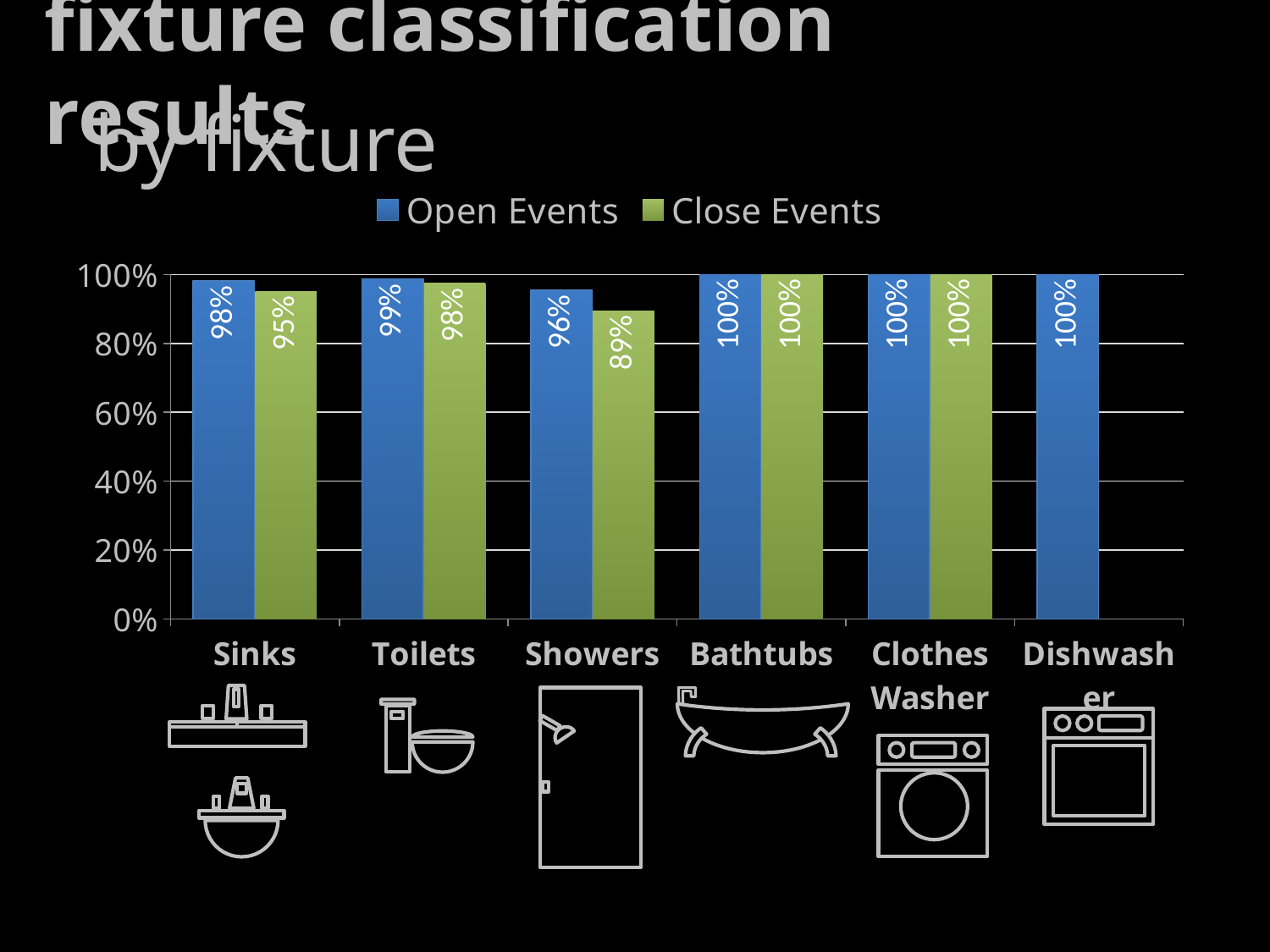
Which fixture has the lowest Close Events value? Showers Which fixture has the lowest Open Events value? Showers Which is larger for Sinks, the Open Events value or the Close Events value? Open Events What is the Open Events value for Dishwasher? 100% How many fixture categories are shown on the x axis? 6 What is the Open Events value for Sinks? 98% What is the Close Events value for Toilets? 98% How many series does the legend list? 2 What is the difference between the Open Events and Close Events values for Showers? 7% What is the difference between the Open Events values for Toilets and Sinks? 1% What kind of chart is shown on the slide? Bar chart What is the Close Events value for Showers? 89%